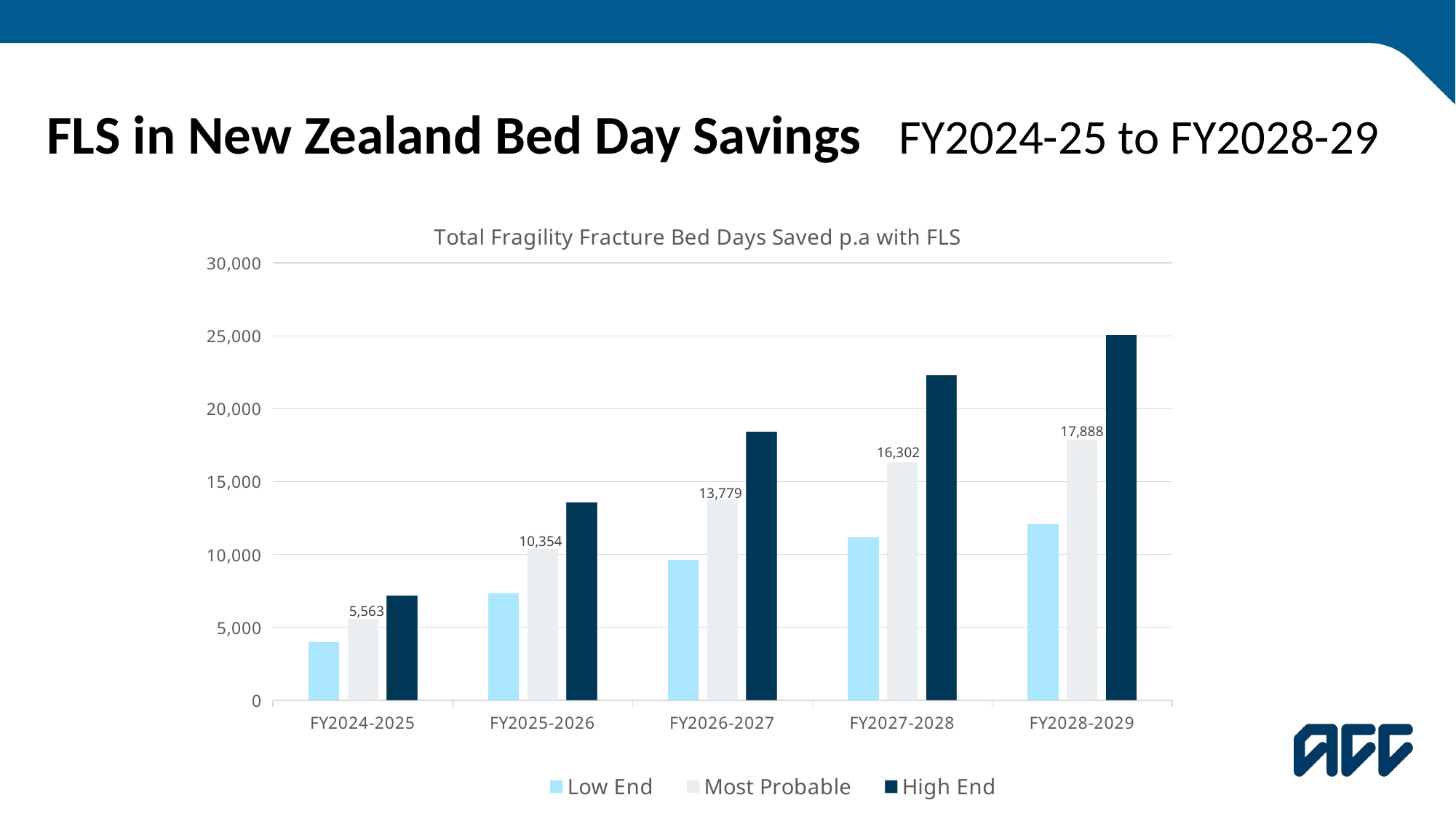
What is the Most Probable value for FY2024-2025? 5,563 Which fiscal year has the lowest Low End value? FY2024-2025 What is the Most Probable value for FY2028-2029? 17,888 Is the Low End value for FY2027-2028 greater or less than 10,000? greater How many series does the legend list? 3 What is the Most Probable value for FY2026-2027? 13,779 What kind of chart is shown on the slide? Bar chart What is the difference between the Most Probable values for FY2027-2028 and FY2025-2026? 5,948 Which fiscal year has the highest Most Probable value? FY2028-2029 How many fiscal years are shown on the x axis? 5